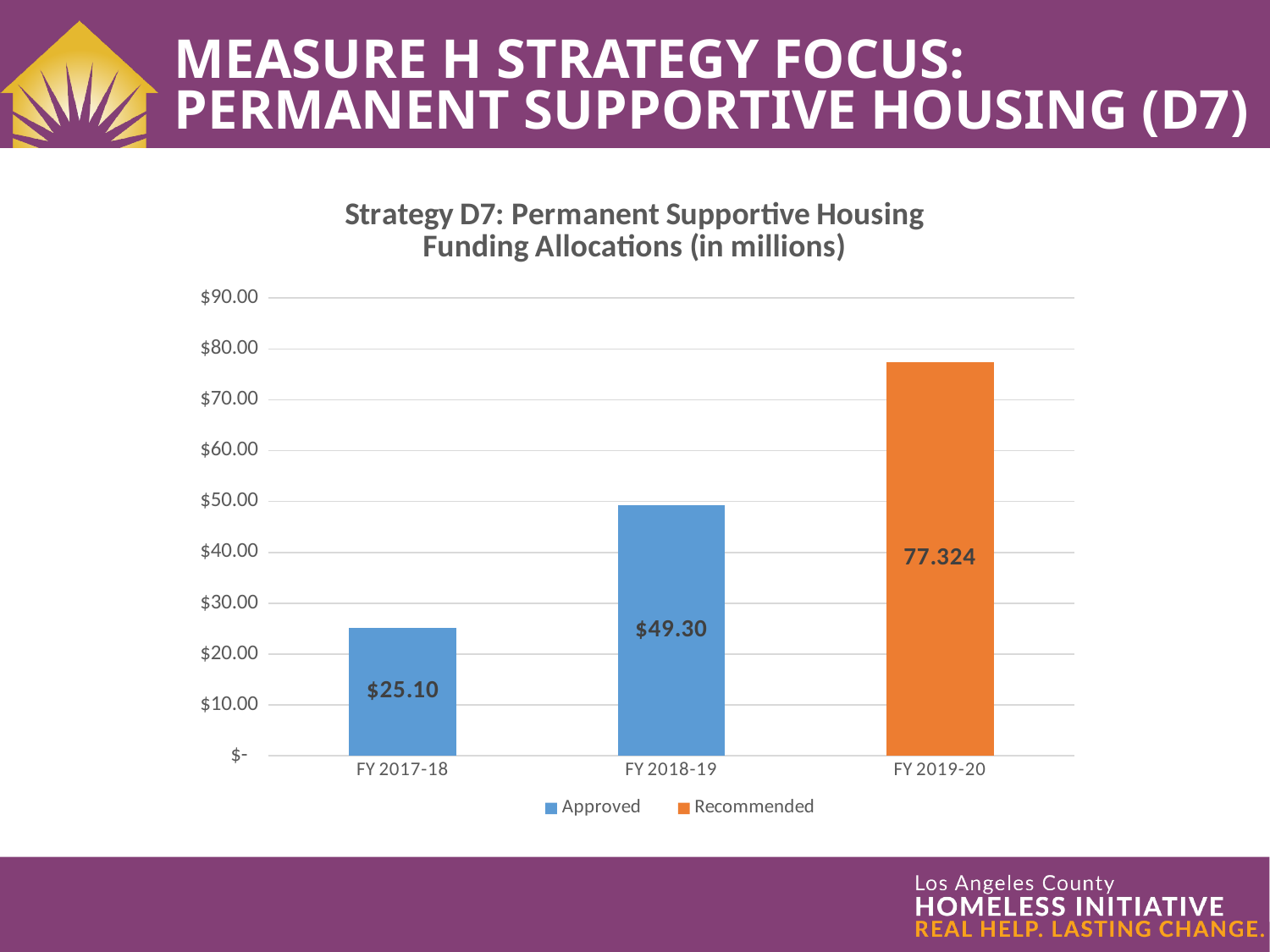
What is the difference between the FY 2018-19 and FY 2017-18 values? $24.20 Do the funding allocations rise or fall from FY 2017-18 to FY 2019-20? rise What kind of chart is shown on the slide? bar chart Which fiscal year has the lowest funding allocation? FY 2017-18 Which fiscal year has the highest funding allocation? FY 2019-20 What is the value for FY 2017-18? $25.10 How many series does the legend list? 2 What is the value for FY 2018-19? $49.30 What is the value for FY 2019-20? 77.324 Which is larger, the value for FY 2018-19 or FY 2017-18? FY 2018-19 Is the value for FY 2019-20 greater or less than $70.00? greater How many fiscal years are shown on the chart? 3